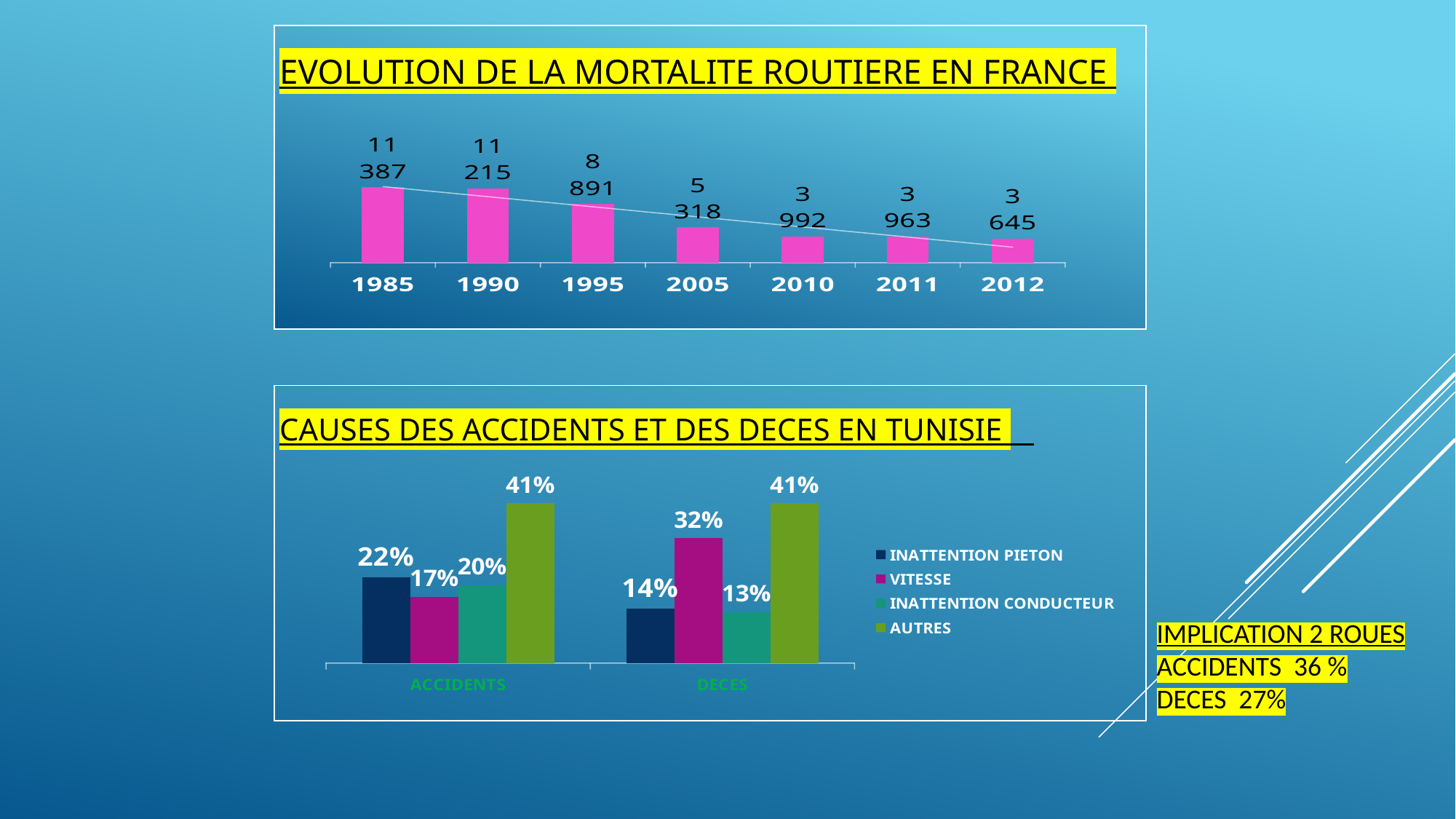
In the chart 'CAUSES DES ACCIDENTS ET DES DECES EN TUNISIE', what is the value of INATTENTION CONDUCTEUR for ACCIDENTS? 20% What kind of chart is 'CAUSES DES ACCIDENTS ET DES DECES EN TUNISIE'? bar chart In the chart 'CAUSES DES ACCIDENTS ET DES DECES EN TUNISIE', which series has the highest value for ACCIDENTS? AUTRES In the chart 'CAUSES DES ACCIDENTS ET DES DECES EN TUNISIE', what is the value of VITESSE for DECES? 32% In the chart 'CAUSES DES ACCIDENTS ET DES DECES EN TUNISIE', which is larger: INATTENTION PIETON for ACCIDENTS or INATTENTION PIETON for DECES? INATTENTION PIETON for ACCIDENTS In the chart 'EVOLUTION DE LA MORTALITE ROUTIERE EN FRANCE', what is the value for 1985? 11 387 In the chart 'EVOLUTION DE LA MORTALITE ROUTIERE EN FRANCE', what is the value for 2012? 3 645 In the chart 'EVOLUTION DE LA MORTALITE ROUTIERE EN FRANCE', what is the difference between the values for 1995 and 2005? 3 573 In the chart 'EVOLUTION DE LA MORTALITE ROUTIERE EN FRANCE', which year has the lowest value? 2012 In the chart 'CAUSES DES ACCIDENTS ET DES DECES EN TUNISIE', how many series does the legend list? 4 In the chart 'EVOLUTION DE LA MORTALITE ROUTIERE EN FRANCE', how many years are shown on the x axis? 7 In the chart 'EVOLUTION DE LA MORTALITE ROUTIERE EN FRANCE', do the values rise or fall from 1985 to 2012? fall